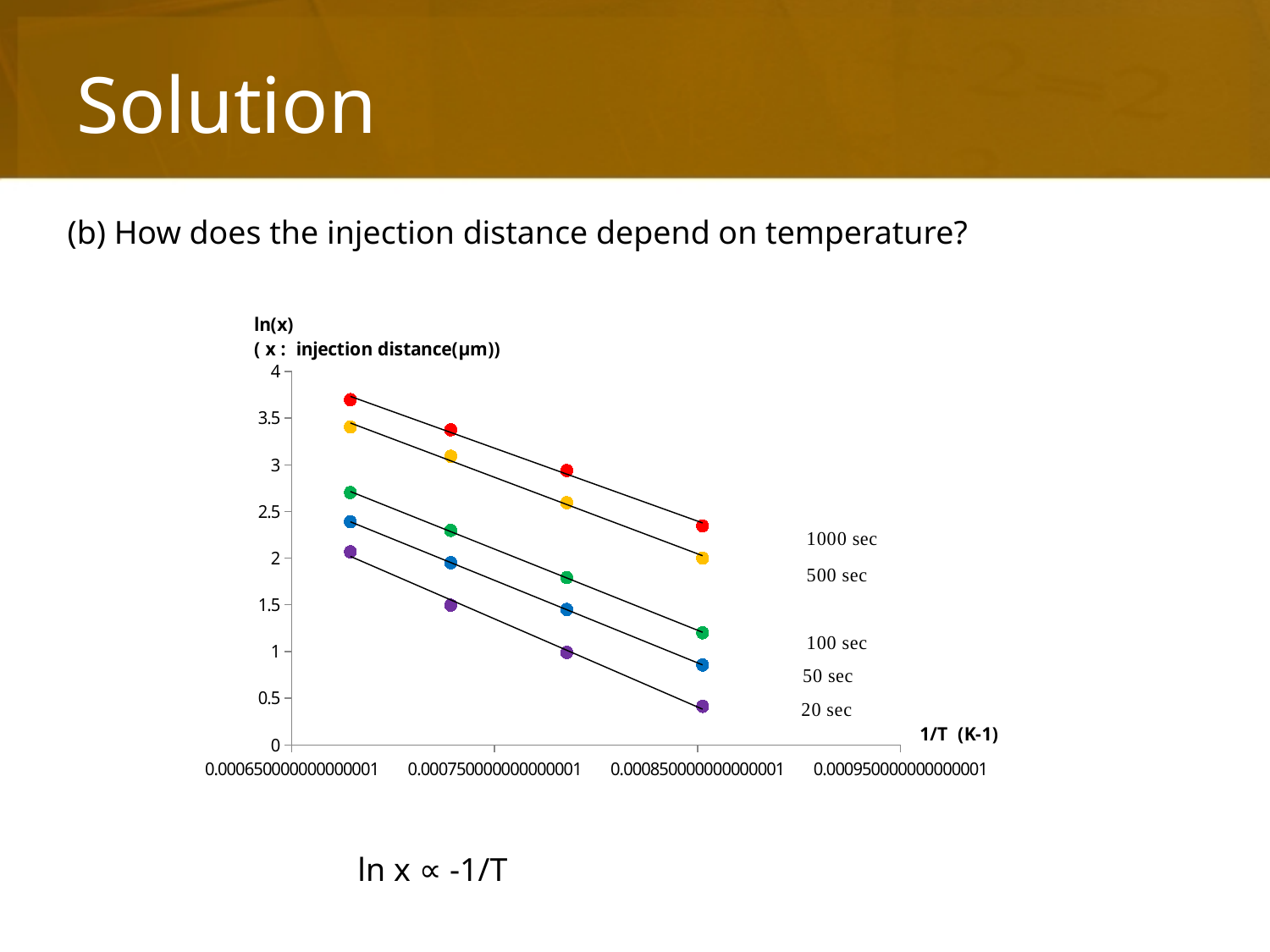
Is the leftmost ln(x) value for the 1000 sec series greater or less than 3.5? greater Is the leftmost ln(x) value for the 50 sec series greater or less than 2? greater Do the ln(x) values rise or fall as 1/T increases along the x axis? fall At the same 1/T value, which series has the larger ln(x): 500 sec or 100 sec? 500 sec Which series has the highest ln(x) values? 1000 sec Is the rightmost ln(x) value for the 20 sec series greater or less than 1? less What kind of chart is shown on the slide? scatter chart How many data points does the 1000 sec series have? 4 What is the label of the x axis? 1/T (K-1) Which series has the lowest ln(x) values? 20 sec How many series (time labels) are plotted on the chart? 5 What colour are the points of the 20 sec series? purple